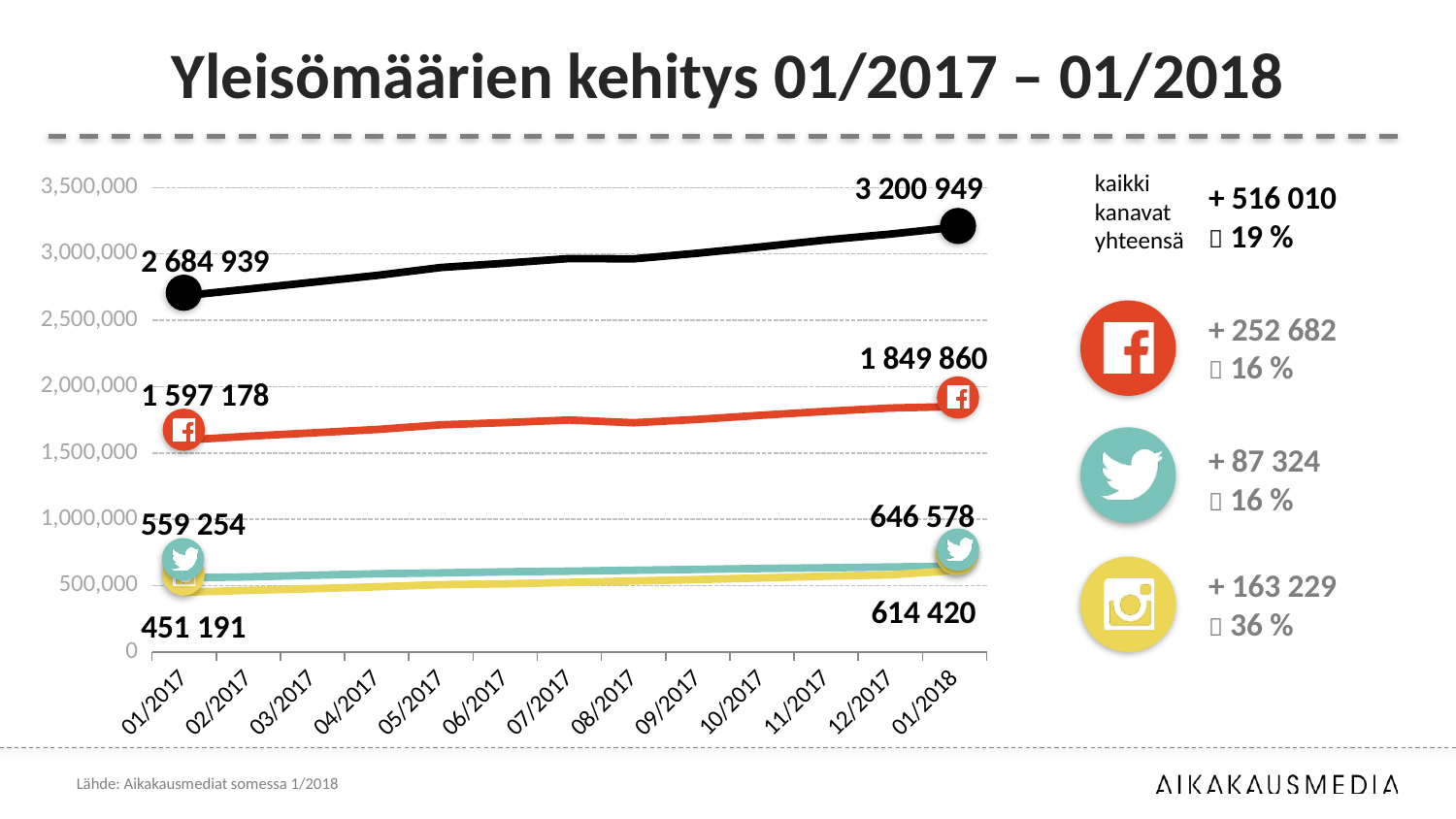
What is the value of the Instagram (yellow) line at 01/2017? 451 191 By how much did the Facebook (red) line increase from 01/2017 to 01/2018? 252 682 Do the values of the black (total) line rise or fall from 01/2017 to 01/2018? rise At 01/2018, which is larger: the Twitter (teal) value or the Instagram (yellow) value? Twitter (646 578) How many lines are plotted on the chart? 4 What is the value of the Twitter (teal) line at 01/2018? 646 578 Is the value of the Facebook (red) line at 07/2017 greater or less than 1,500,000? greater What kind of chart is shown on the slide? line chart How many months are shown on the x axis? 13 What percentage growth is shown for Instagram on the right side of the slide? 36 % What is the value of the black (total) line at 01/2018? 3 200 949 What is the value of the Facebook (red) line at 01/2017? 1 597 178